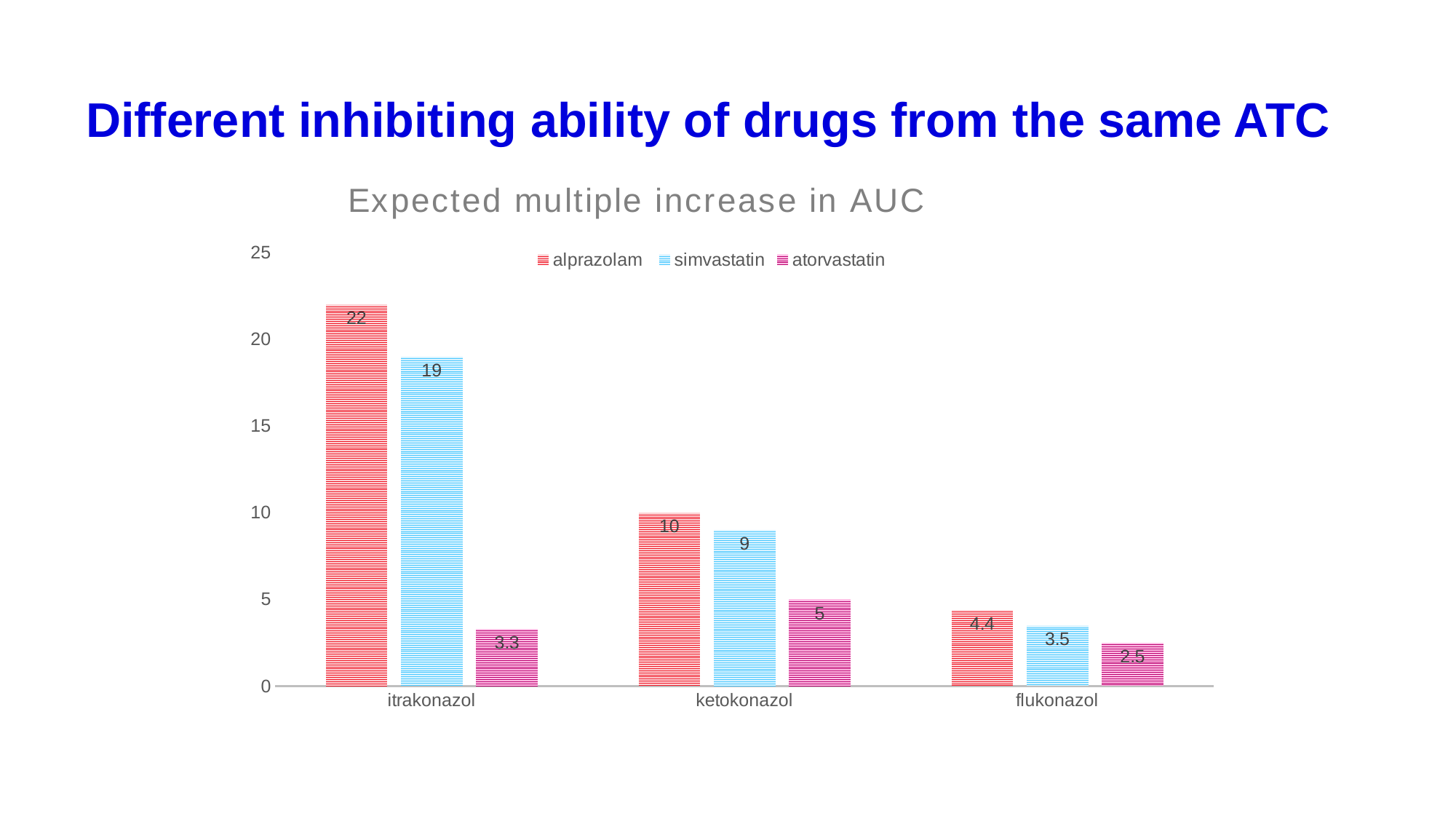
Is the value for simvastatin with itrakonazol greater or less than 15? greater How many series does the legend list? 3 How many inhibitor categories are shown on the x axis? 3 What is the value for atorvastatin with flukonazol? 2.5 What is the title of the chart? Expected multiple increase in AUC What is the value for simvastatin with ketokonazol? 9 Which inhibitor has the lowest value for simvastatin? flukonazol What is the difference between the alprazolam and simvastatin values for itrakonazol? 3 Which inhibitor has the highest value for alprazolam? itrakonazol What kind of chart is shown on the slide? bar chart What is the value for alprazolam with itrakonazol? 22 Which is larger for ketokonazol: the alprazolam value or the atorvastatin value? alprazolam